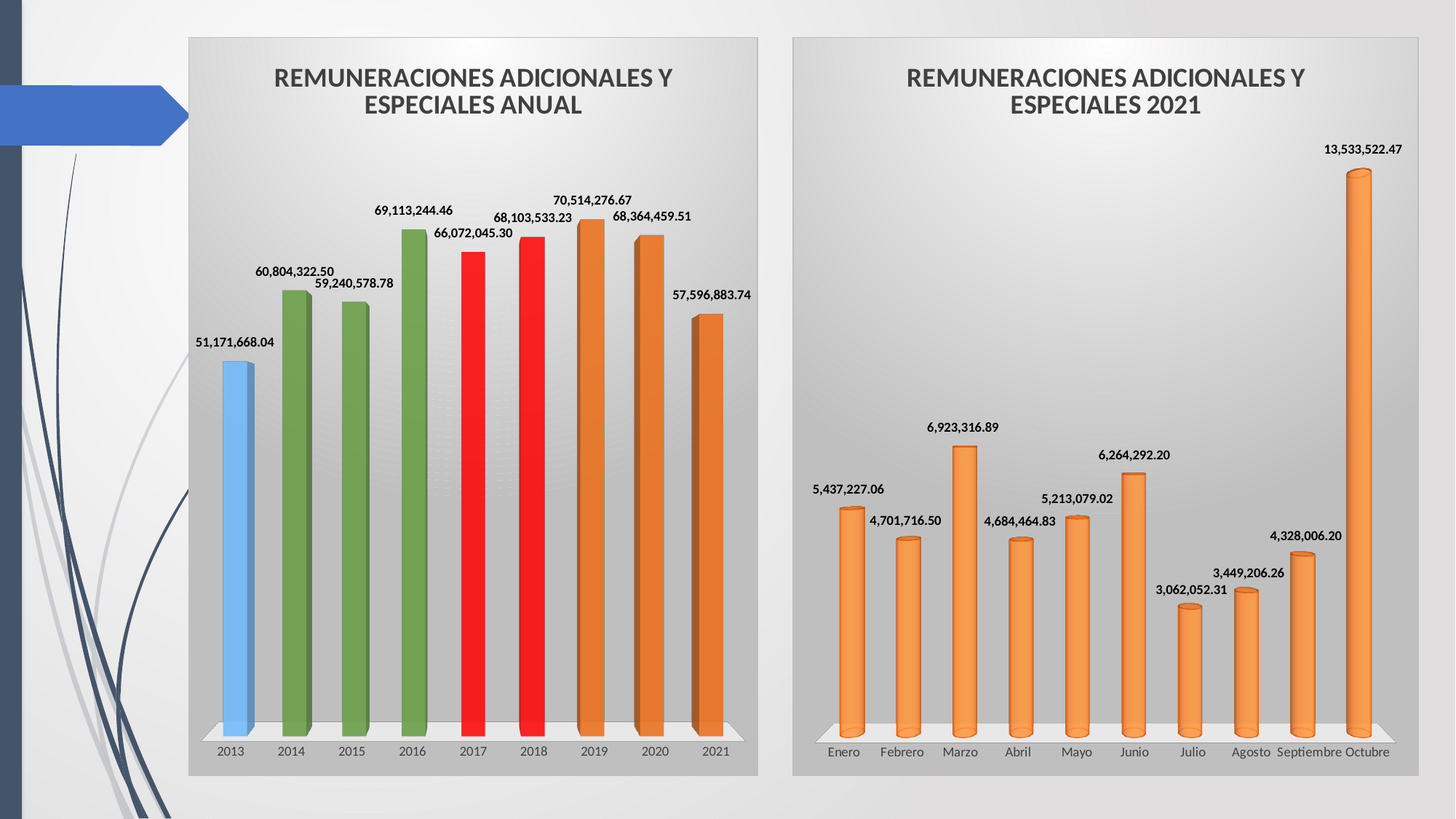
In the chart titled REMUNERACIONES ADICIONALES Y ESPECIALES ANUAL, how many years are shown? 9 In the chart titled REMUNERACIONES ADICIONALES Y ESPECIALES ANUAL, which is larger, the value for 2016 or the value for 2018? 2016 In the chart titled REMUNERACIONES ADICIONALES Y ESPECIALES ANUAL, which year has the lowest value? 2013 What kind of chart is the chart titled REMUNERACIONES ADICIONALES Y ESPECIALES 2021? Bar chart In the chart titled REMUNERACIONES ADICIONALES Y ESPECIALES ANUAL, what is the difference between the values for 2019 and 2013? 19,342,608.63 In the chart titled REMUNERACIONES ADICIONALES Y ESPECIALES 2021, how many months are shown? 10 In the chart titled REMUNERACIONES ADICIONALES Y ESPECIALES 2021, what is the value for Marzo? 6,923,316.89 In the chart titled REMUNERACIONES ADICIONALES Y ESPECIALES ANUAL, what is the value for 2013? 51,171,668.04 In the chart titled REMUNERACIONES ADICIONALES Y ESPECIALES 2021, what is the difference between the values for Octubre and Julio? 10,471,470.16 In the chart titled REMUNERACIONES ADICIONALES Y ESPECIALES ANUAL, which year has the highest value? 2019 In the chart titled REMUNERACIONES ADICIONALES Y ESPECIALES 2021, which month has the highest value? Octubre In the chart titled REMUNERACIONES ADICIONALES Y ESPECIALES 2021, which month has the lowest value? Julio